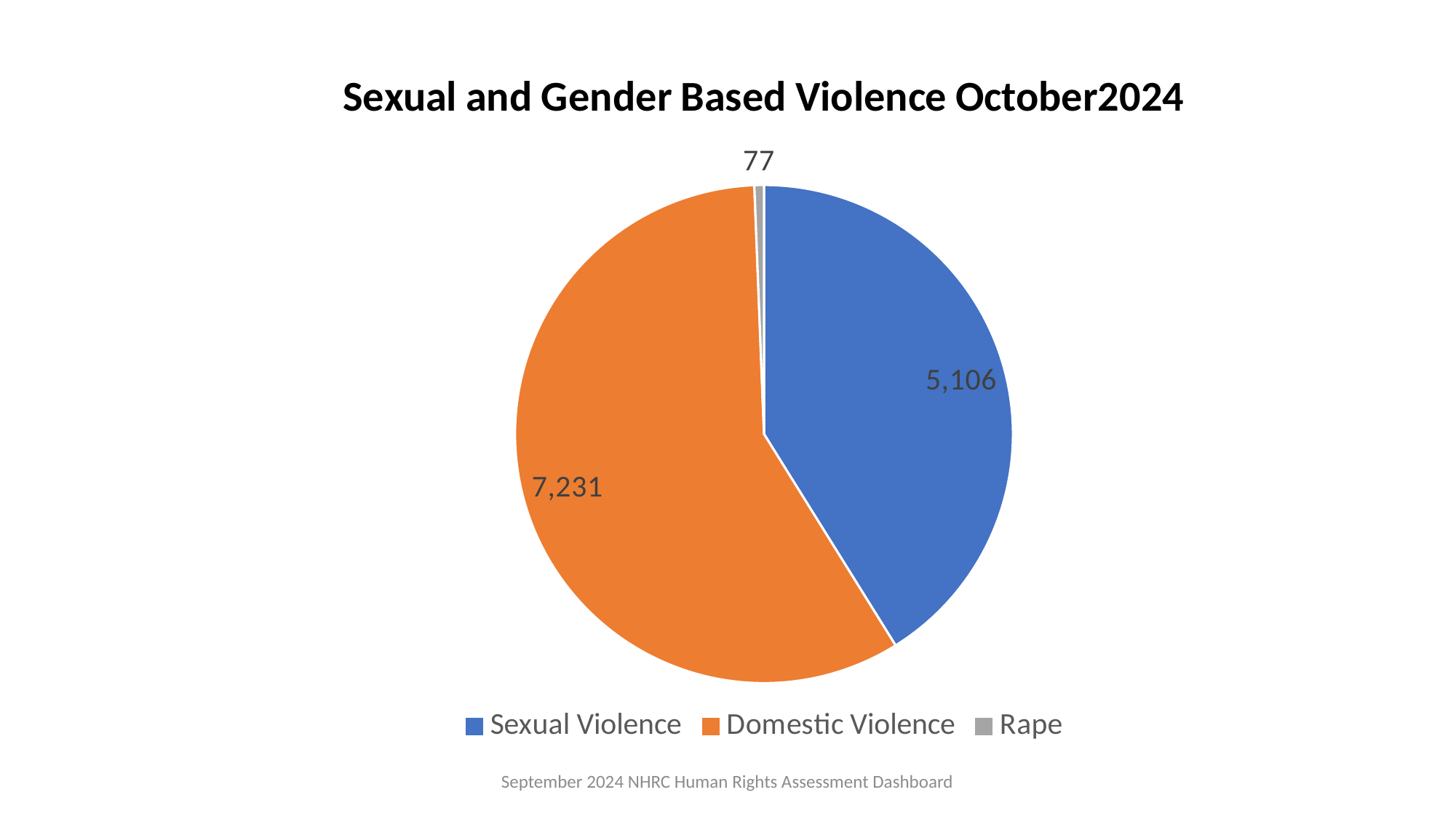
Which category has the largest slice of the pie? Domestic Violence Which category has the smallest slice of the pie? Rape What is the title of the chart? Sexual and Gender Based Violence October2024 What is the total of all three slices in the pie chart? 12,414 What is the difference between the Sexual Violence and Rape values? 5,029 What kind of chart is shown on the slide? Pie chart What is the value for Sexual Violence? 5,106 How many categories are shown in the pie chart? 3 What is the difference between the Domestic Violence and Sexual Violence values? 2,125 What is the value for Rape? 77 What is the value for Domestic Violence? 7,231 Which is larger, Sexual Violence or Domestic Violence? Domestic Violence